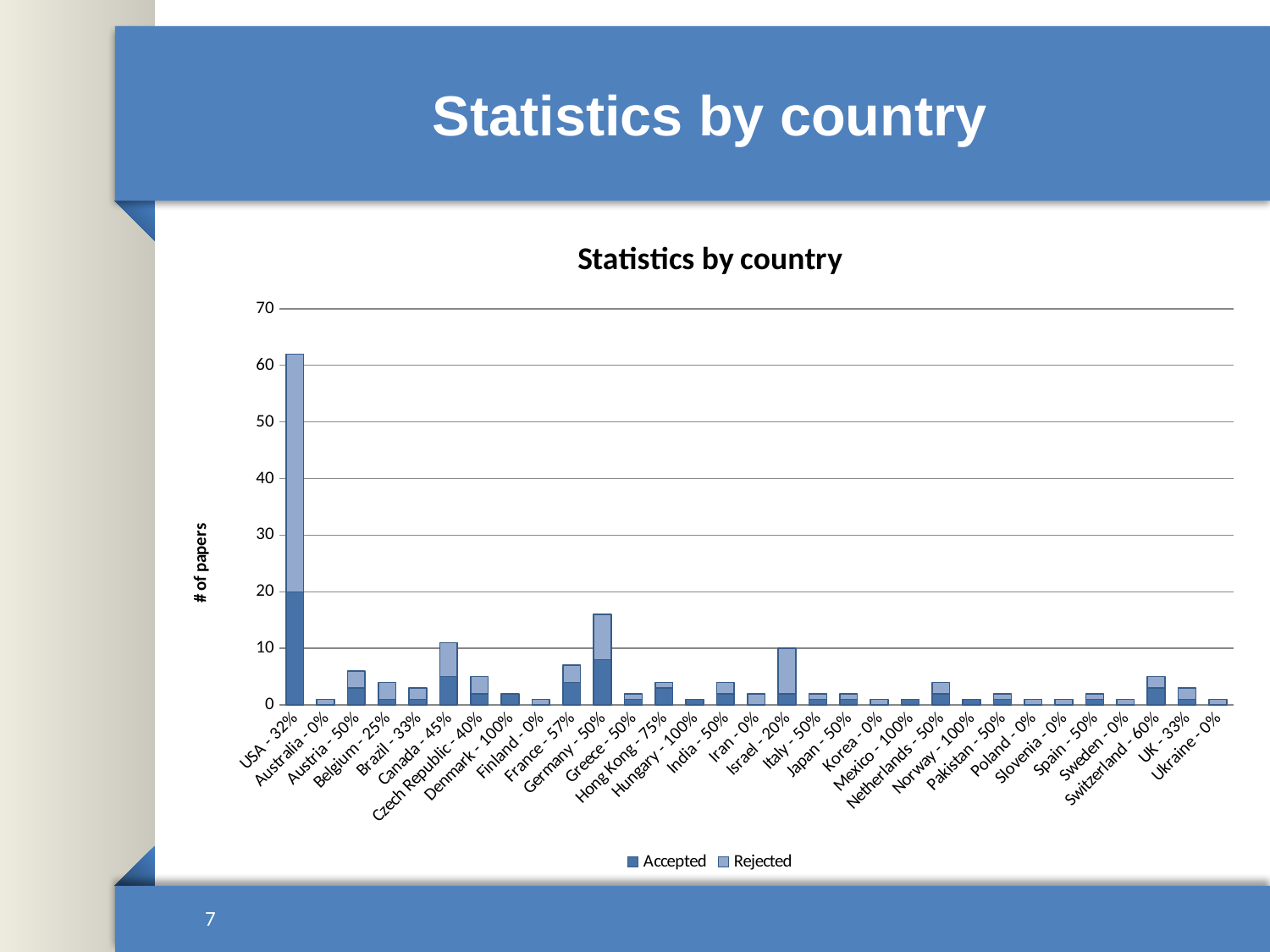
Which country has the highest total number of papers? USA - 32% What is the Accepted value for USA - 32%? 20 Is the total number of papers for France - 57% greater or less than 10? less How many series does the legend list? 2 What is the label on the vertical axis? # of papers Is the total number of papers for USA - 32% greater or less than 60? greater How many countries are shown along the x axis? 31 What are the two series named in the legend? Accepted and Rejected What kind of chart is shown on the slide? Stacked bar chart Is the total number of papers for Germany - 50% greater or less than 10? greater Which has a larger total number of papers, Germany - 50% or Canada - 45%? Germany - 50% What is the total number of papers for Israel - 20%? 10